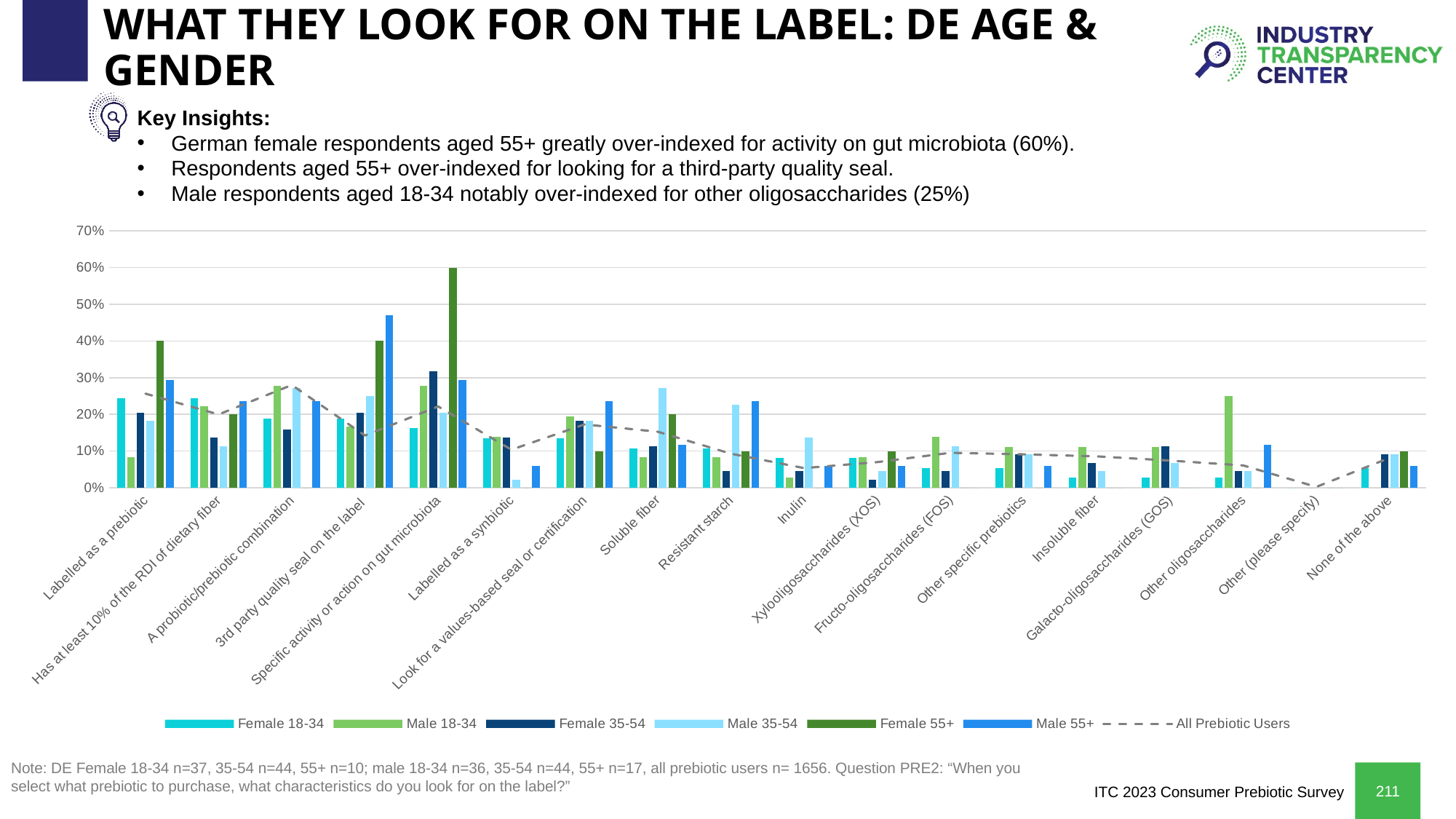
For 'Labelled as a prebiotic', which is larger: the Female 55+ value or the Female 18-34 value? Female 55+ How many label characteristics (categories) are shown along the x axis? 18 Is the value for Male 55+ on '3rd party quality seal on the label' greater or less than 40%? greater Which series is drawn as a dashed line rather than bars? All Prebiotic Users Is the value for Male 35-54 on 'Soluble fiber' greater or less than 20%? greater Which series has the highest value for '3rd party quality seal on the label'? Male 55+ What is the value for Female 55+ on 'Specific activity or action on gut microbiota'? 60% Which series has the highest value for 'Other oligosaccharides'? Male 18-34 Which category has the highest Female 55+ value? Specific activity or action on gut microbiota How many series does the chart legend list? 7 What is the value for Male 18-34 on 'Other oligosaccharides'? 25% What kind of chart is shown on the slide? combination bar and line chart